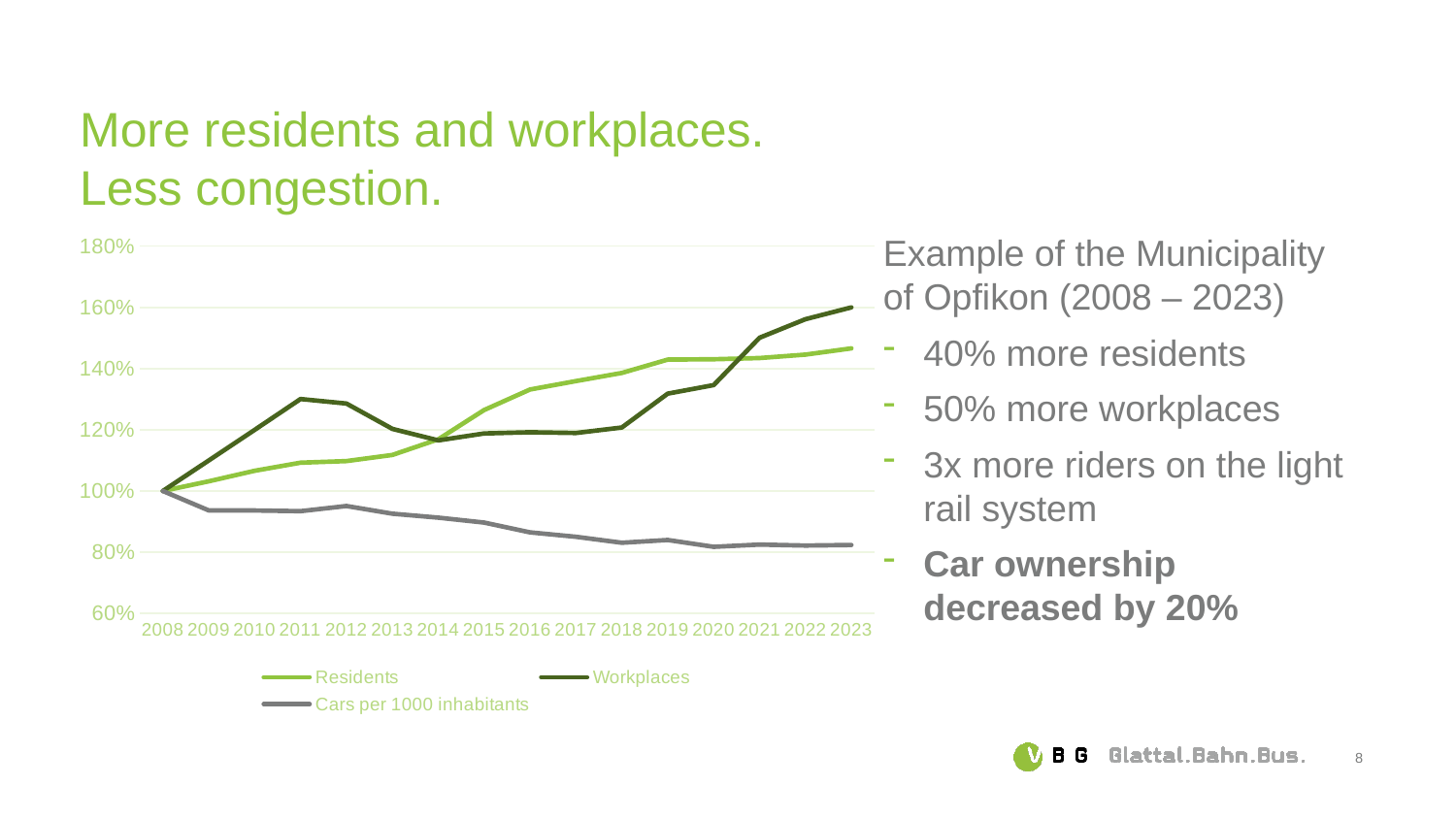
Is the value for Residents in 2023 greater or less than 140%? greater What is the value for Residents in 2008? 100% Which series has the lowest value in 2023? Cars per 1000 inhabitants Is the value for Workplaces in 2023 greater or less than 140%? greater What is the value for Cars per 1000 inhabitants in 2008? 100% Do the values for Cars per 1000 inhabitants rise or fall from 2008 to 2023? fall In 2023, which is higher: Residents or Workplaces? Workplaces How many series does the chart's legend list? 3 What kind of chart is shown on the slide? line chart In 2011, which is higher: Residents or Workplaces? Workplaces How many years are shown along the x axis of the chart? 16 Is the value for Cars per 1000 inhabitants in 2023 greater or less than 100%? less